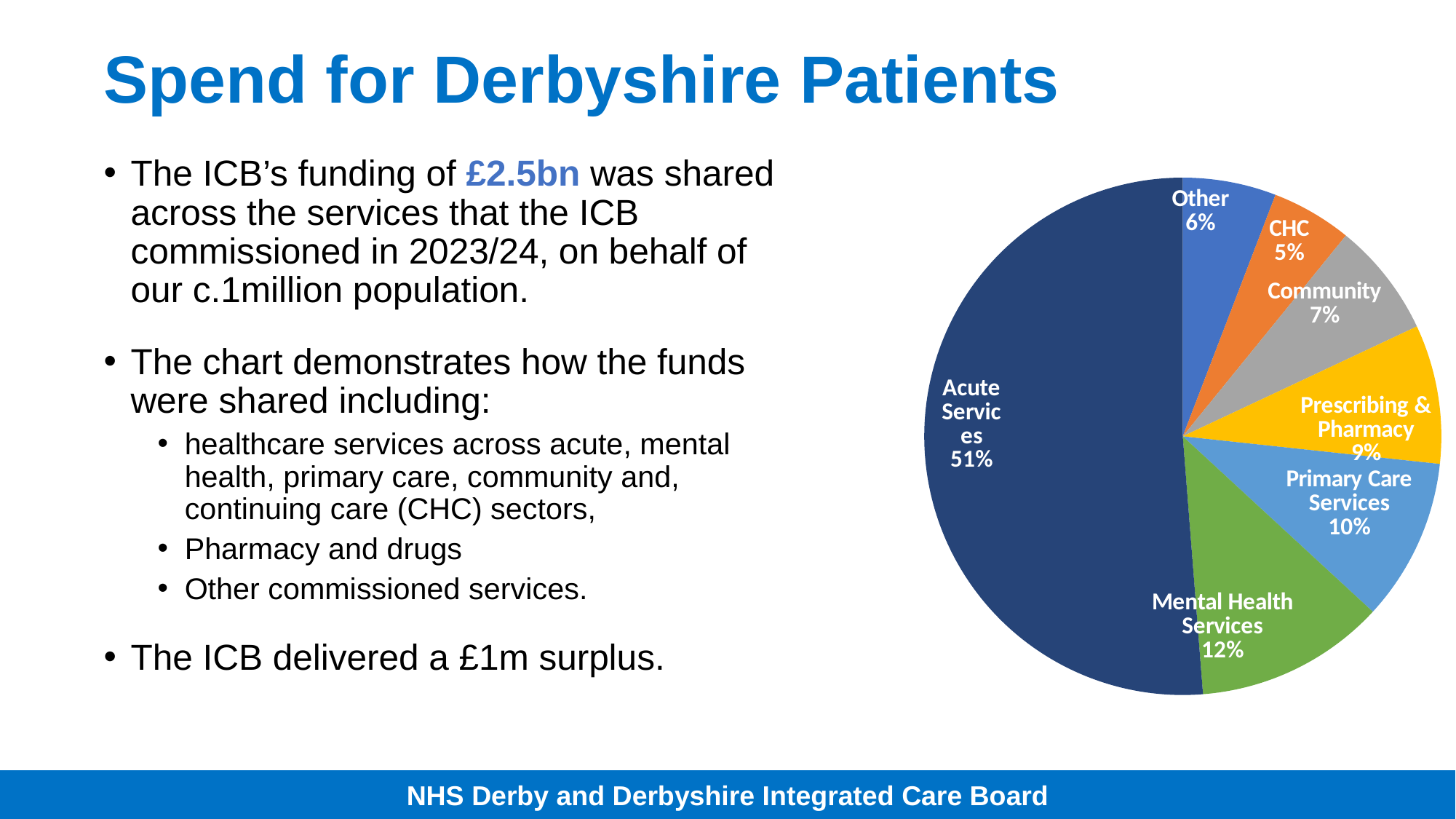
What percentage is shown for CHC? 5% What is the difference in percentage points between Mental Health Services and Community? 5 What percentage is shown for Primary Care Services? 10% Which slice of the pie is the smallest? CHC What share of the pie does Acute Services take? 51% What kind of chart is shown on the slide? Pie chart What percentage is shown for Prescribing & Pharmacy? 9% How many slices does the pie chart have? 7 What colour is the Prescribing & Pharmacy slice? Yellow Which is larger, the share for Other or the share for Community? Community What percentage is shown for Mental Health Services? 12% Which slice of the pie is the largest? Acute Services